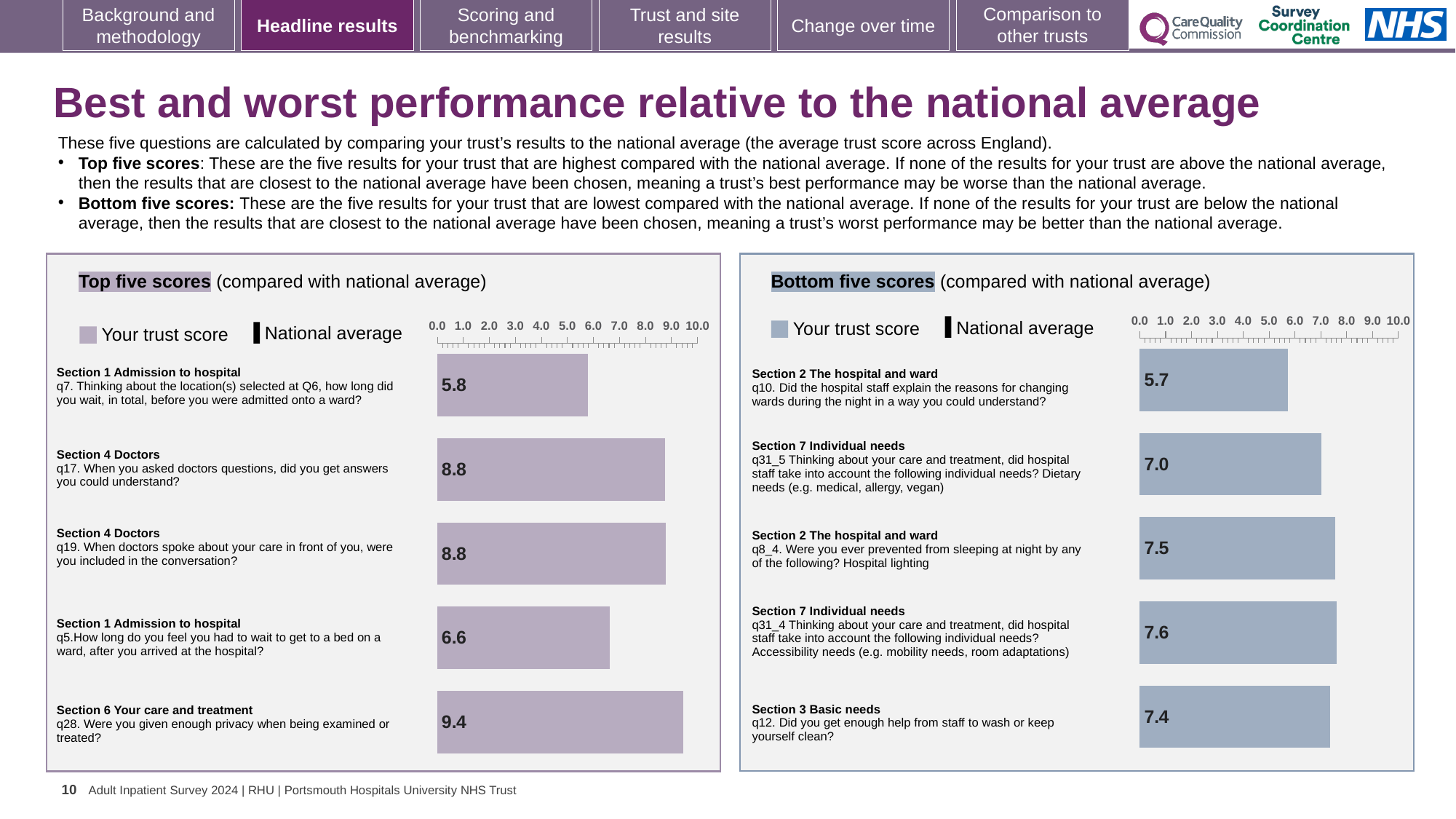
What type of chart is used in the Bottom five scores panel? Bar chart In the Top five scores chart, what is the trust score for q28 (Were you given enough privacy when being examined or treated?)? 9.4 In the Top five scores chart, which question has the lowest trust score? q7. Thinking about the location(s) selected at Q6, how long did you wait, in total, before you were admitted onto a ward? In the Bottom five scores chart, what is the trust score for q10 (Did the hospital staff explain the reasons for changing wards during the night)? 5.7 How many questions are shown in the Top five scores chart? 5 In the Top five scores chart, what is the difference between the trust scores for q28 and q5? 2.8 In the Top five scores chart, which question has the highest trust score? q28. Were you given enough privacy when being examined or treated? In the Top five scores chart, what is the trust score for q7 (how long did you wait before being admitted onto a ward)? 5.8 In the Bottom five scores chart, which question has the lowest trust score? q10. Did the hospital staff explain the reasons for changing wards during the night in a way you could understand? In the Bottom five scores chart, which question has the highest trust score? q31_4 Accessibility needs (e.g. mobility needs, room adaptations) In the Bottom five scores chart, what is the trust score for q12 (Did you get enough help from staff to wash or keep yourself clean?)? 7.4 In the Bottom five scores chart, is the trust score for q8_4 (Hospital lighting) larger or smaller than the score for q31_5 (Dietary needs)? larger